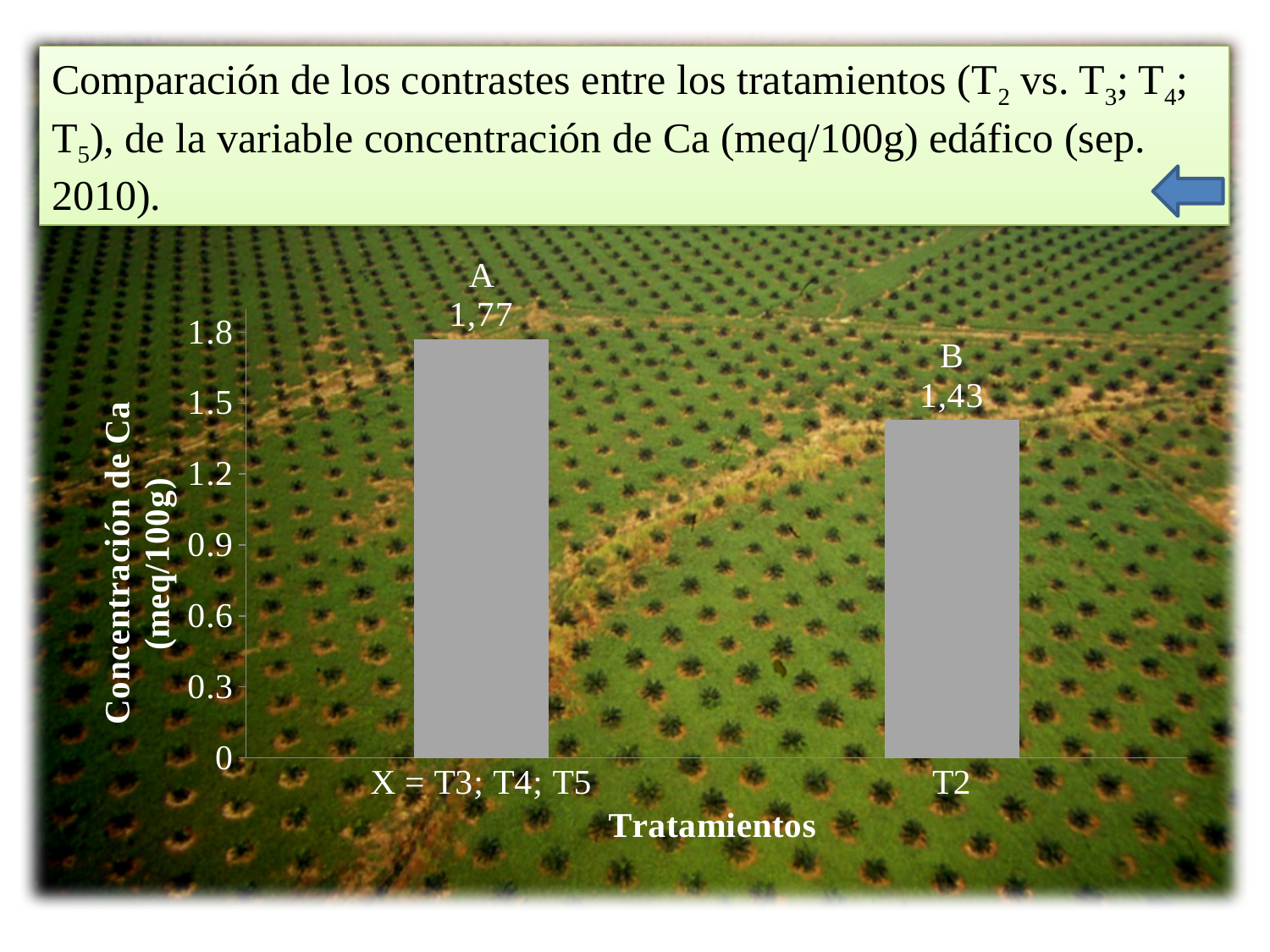
Which category has the highest Ca concentration? X = T3; T4; T5 What is the difference between the Ca concentration for 'X = T3; T4; T5' and for T2? 0,34 What statistical group letter is shown above the T2 bar? B Is the value for 'X = T3; T4; T5' greater or less than 1.5? greater What is the Ca concentration value for the category 'X = T3; T4; T5'? 1,77 How many categories are shown on the x axis of the chart? 2 What is the label of the y axis of the chart? Concentración de Ca (meq/100g) What kind of chart is shown on the slide? Bar chart Is the value for T2 greater or less than 1.5? less Which category has the lowest Ca concentration? T2 What is the Ca concentration value for T2? 1,43 Which has a larger Ca concentration, 'X = T3; T4; T5' or T2? X = T3; T4; T5